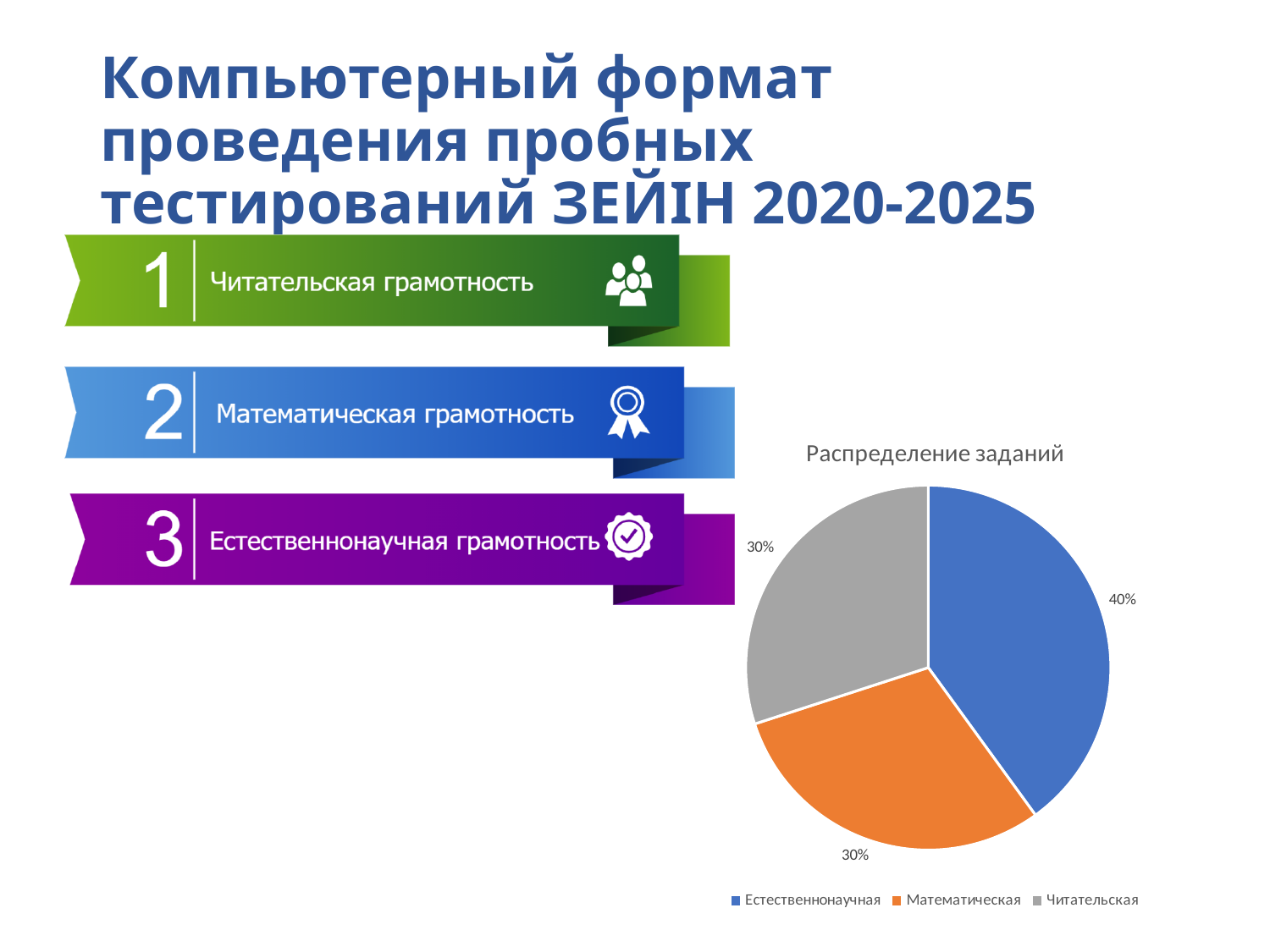
What is the difference between the Естественнонаучная share and the Читательская share? 10% How many slices does the pie chart have? 3 What share of the pie does Читательская take? 30% How many entries does the legend list? 3 What is the title of the chart? Распределение заданий Which is larger, the slice for Естественнонаучная or the slice for Математическая? Естественнонаучная Is the share for Естественнонаучная greater or less than 30%? greater What kind of chart is shown on the slide? pie chart What share of the pie does Естественнонаучная take? 40% Which colour represents Математическая in the pie chart? orange What share of the pie does Математическая take? 30% Which category has the largest slice of the pie? Естественнонаучная